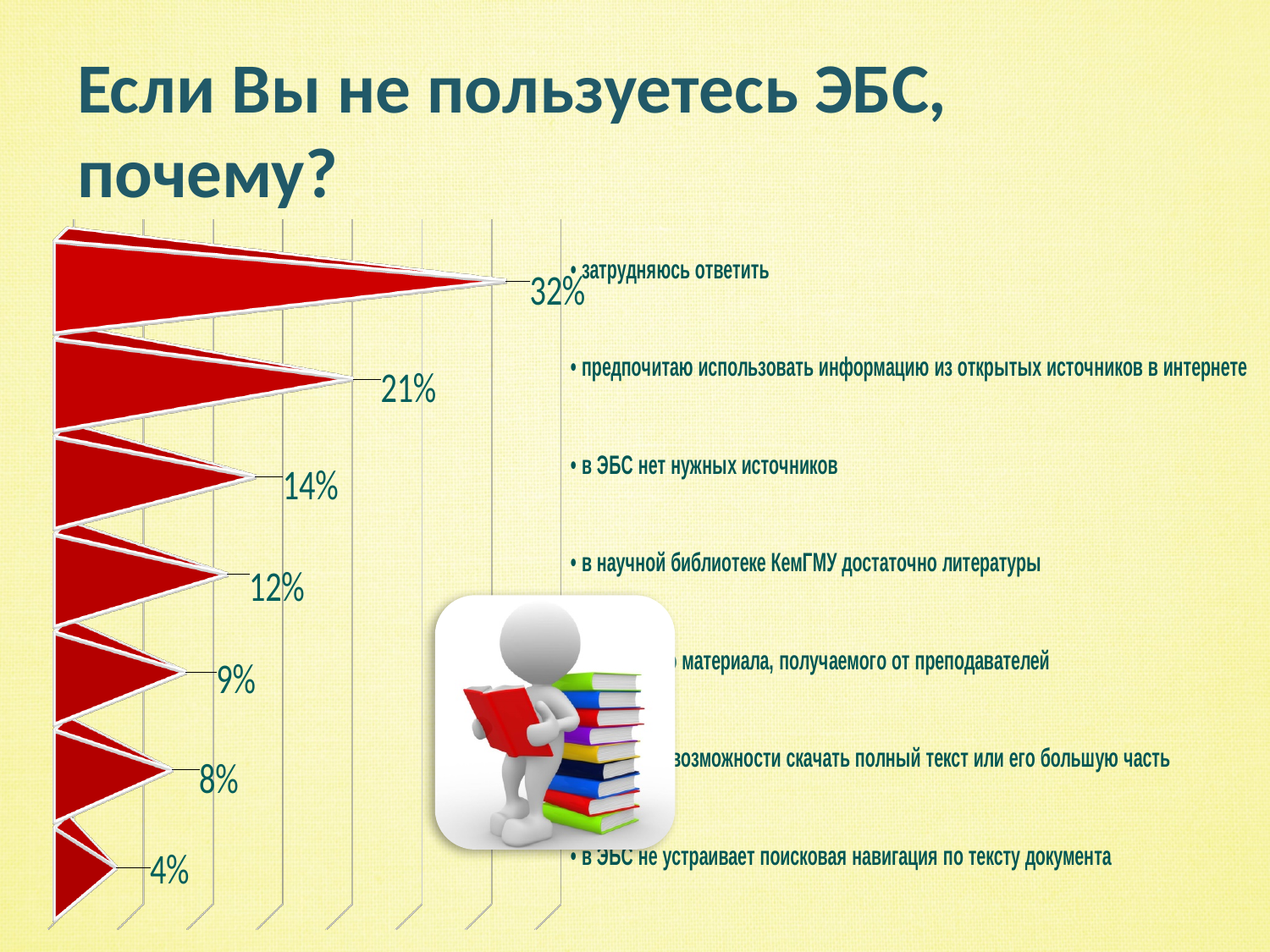
What value is shown for "в научной библиотеке КемГМУ достаточно литературы"? 12% What percentage is shown for "затрудняюсь ответить"? 32% What percentage is shown for "в ЭБС не устраивает поисковая навигация по тексту документа"? 4% What percentage is shown for "в ЭБС нет нужных источников"? 14% Which is larger: the value for "в ЭБС нет нужных источников" or for "в научной библиотеке КемГМУ достаточно литературы"? в ЭБС нет нужных источников What is the difference between the values for "затрудняюсь ответить" and "предпочитаю использовать информацию из открытых источников в интернете"? 11% What value is shown for "предпочитаю использовать информацию из открытых источников в интернете"? 21% What kind of chart is shown on the slide? bar chart How many categories are plotted in the chart? 7 Which category has the highest value? затрудняюсь ответить Which category has the lowest value? в ЭБС не устраивает поисковая навигация по тексту документа What is the title of the slide containing the chart? Если Вы не пользуетесь ЭБС, почему?